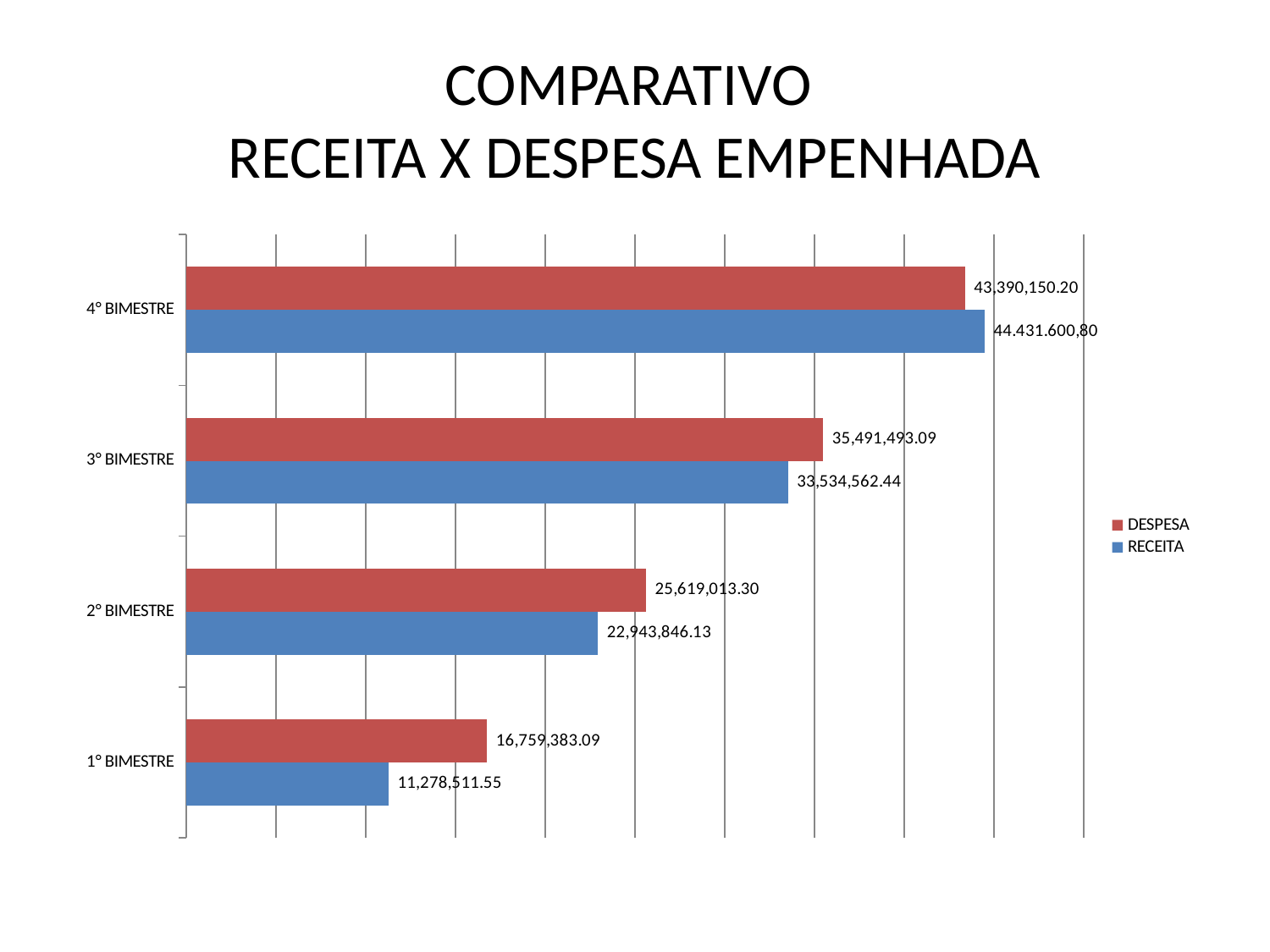
For 3° BIMESTRE, which is larger, DESPESA or RECEITA? DESPESA What is the RECEITA value for 1° BIMESTRE? 11,278,511.55 What is the difference between DESPESA and RECEITA for 1° BIMESTRE? 5,480,871.54 How many bimestres (categories) are shown on the chart? 4 What is the difference between DESPESA and RECEITA for 2° BIMESTRE? 2,675,167.17 What is the RECEITA value for 3° BIMESTRE? 33,534,562.44 What kind of chart is shown on the slide? Bar chart What is the DESPESA value for 2° BIMESTRE? 25,619,013.30 How many series does the legend list? 2 What is the DESPESA value for 4° BIMESTRE? 43,390,150.20 Which bimestre has the lowest DESPESA value? 1° BIMESTRE Which bimestre has the highest RECEITA value? 4° BIMESTRE